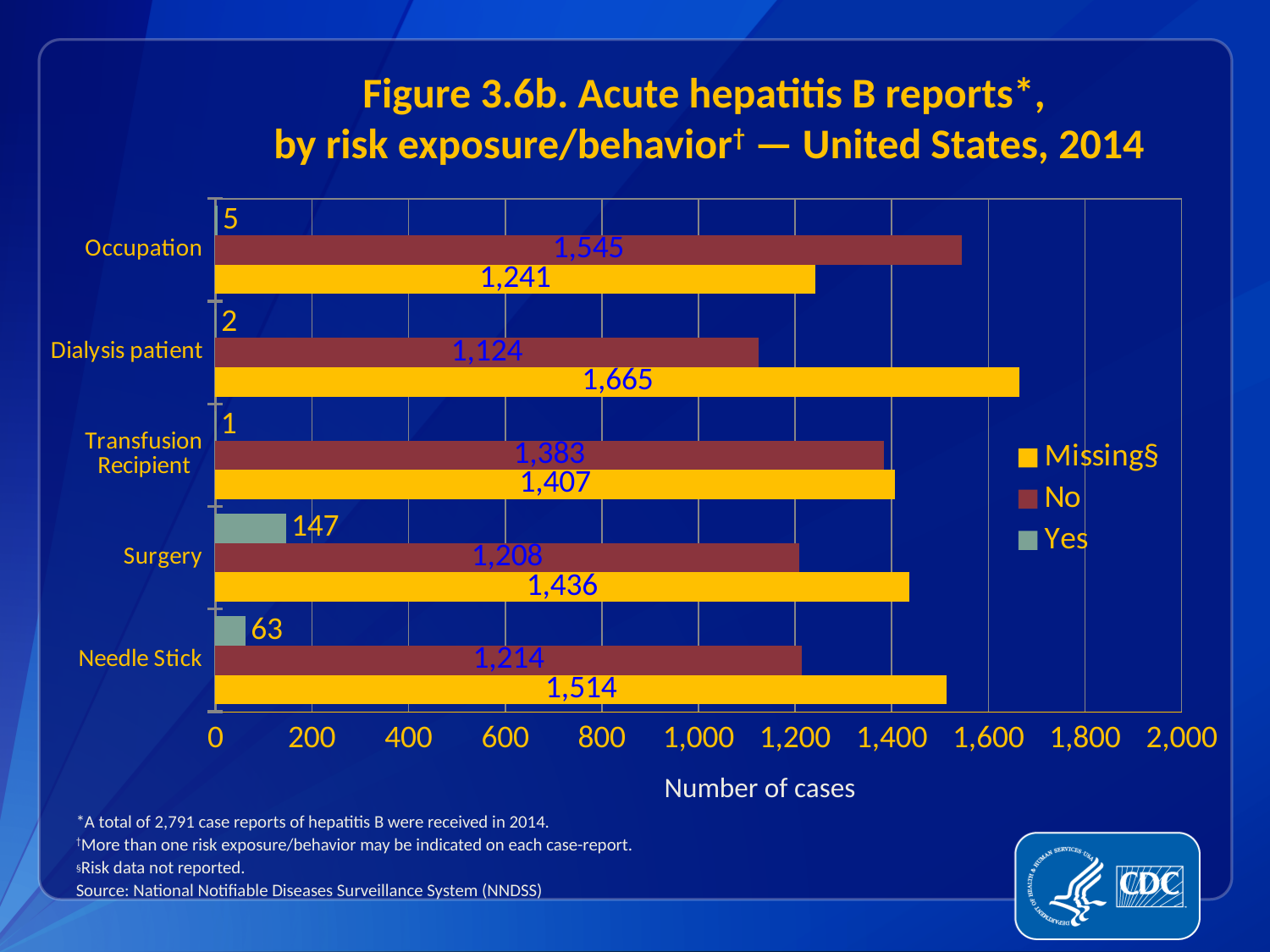
What is the difference between the 'Missing§' and 'No' values for Needle Stick? 300 What is the label of the x axis? Number of cases Which category has the highest value for the 'Yes' series? Surgery What is the number of cases for the 'Missing§' series for Dialysis patient? 1,665 How many series does the legend list? 3 Which is larger for Dialysis patient: the 'No' value or the 'Missing§' value? Missing§ What kind of chart is shown on the slide? Bar chart What is the number of cases for the 'Yes' series for Needle Stick? 63 How many risk exposure/behavior categories are shown on the chart? 5 What is the number of cases for the 'No' series for Occupation? 1,545 Which category has the lowest value for the 'Yes' series? Transfusion Recipient What is the number of cases for the 'Yes' series for Surgery? 147